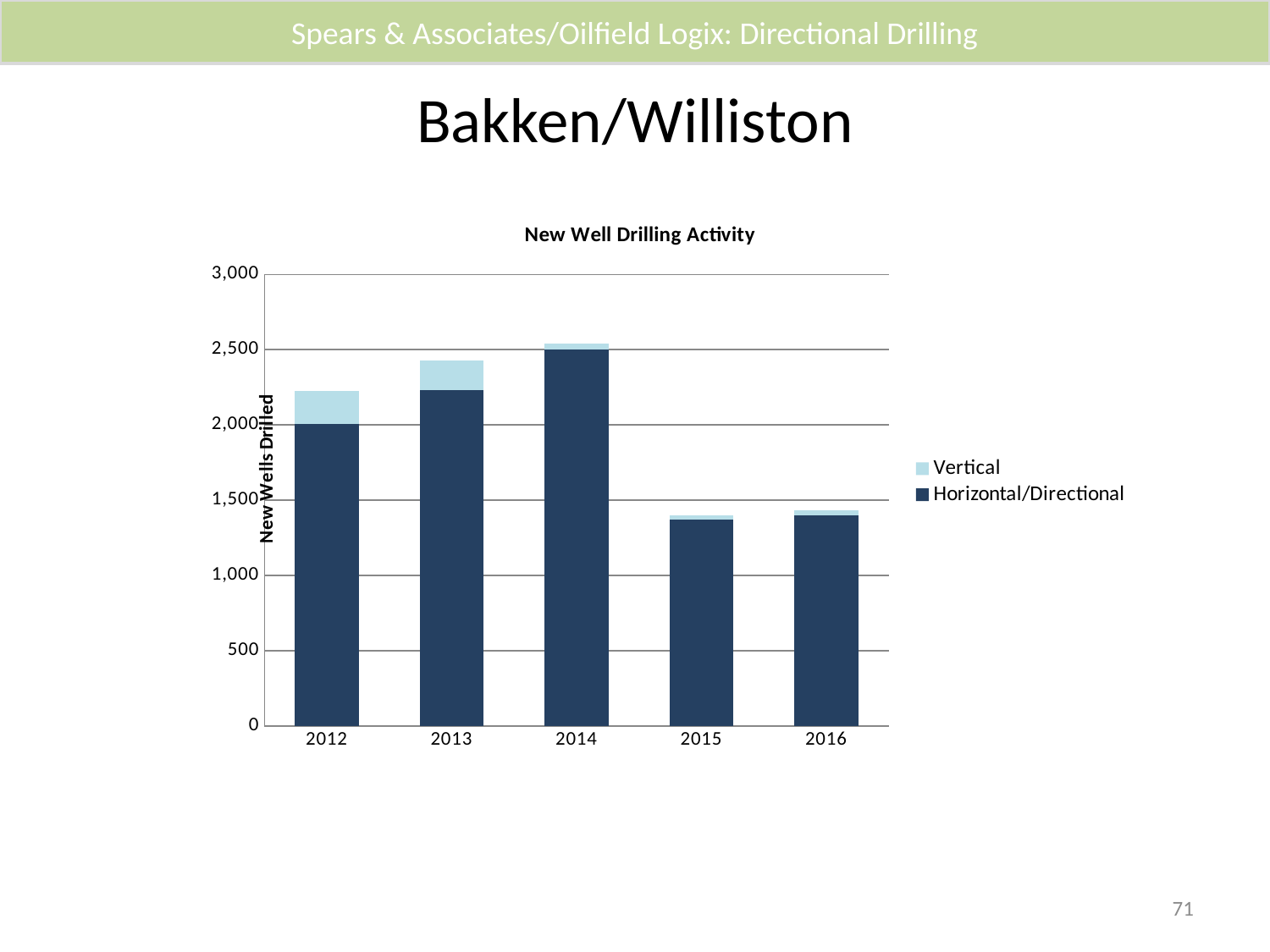
What kind of chart is shown on the slide? Stacked bar chart What is the title of the chart? New Well Drilling Activity Which year has the larger total bar, 2013 or 2015? 2013 Which year has the tallest total bar in the chart? 2014 Is the total bar for 2015 greater or less than 1,500? less How many years are shown on the x axis of the chart? 5 Do the total bars rise or fall from 2014 to 2016? fall What is the label on the vertical axis of the chart? New Wells Drilled Is the Horizontal/Directional value for 2013 greater or less than 2,000? greater Is the Horizontal/Directional value for 2012 greater or less than 1,500? greater How many series does the chart's legend list? 2